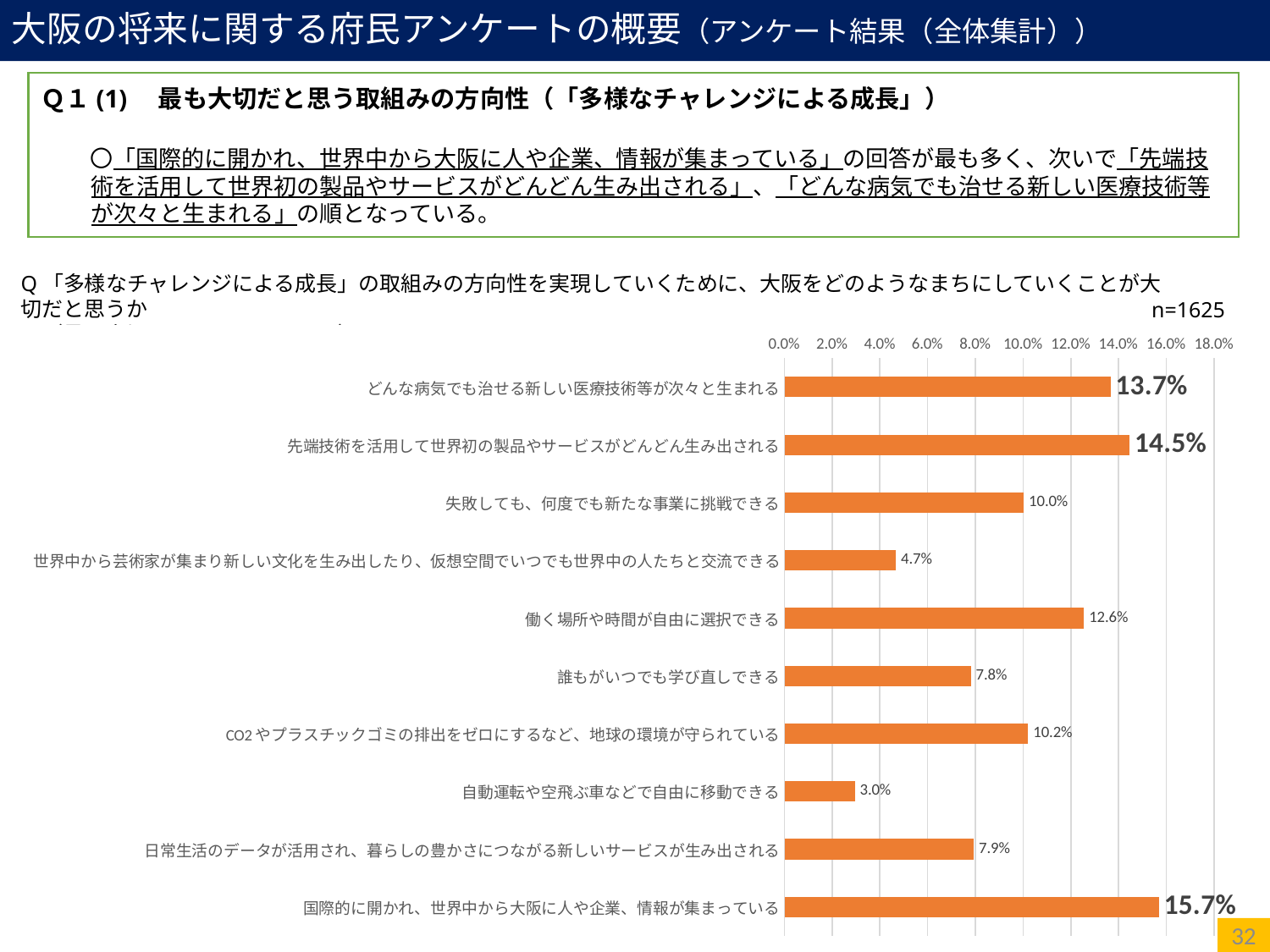
What is the difference between the values for 「国際的に開かれ、世界中から大阪に人や企業、情報が集まっている」 and 「先端技術を活用して世界初の製品やサービスがどんどん生み出される」? 1.2 percentage points How many categories (response options) are plotted in the chart? 10 What is the value for 「自動運転や空飛ぶ車などで自由に移動できる」? 3.0% What kind of chart is shown on the slide? Bar chart What is the value for 「CO2やプラスチックゴミの排出をゼロにするなど、地球の環境が守られている」? 10.2% What is the value for 「働く場所や時間が自由に選択できる」? 12.6% Which is larger: the value for 「働く場所や時間が自由に選択できる」 or for 「失敗しても、何度でも新たな事業に挑戦できる」? 働く場所や時間が自由に選択できる Which category has the highest value in the chart? 国際的に開かれ、世界中から大阪に人や企業、情報が集まっている Is the value for 「誰もがいつでも学び直しできる」 greater or less than 8.0%? less What is the sample size (n) shown for the chart? n=1625 Which category has the lowest value in the chart? 自動運転や空飛ぶ車などで自由に移動できる What is the value for 「国際的に開かれ、世界中から大阪に人や企業、情報が集まっている」? 15.7%